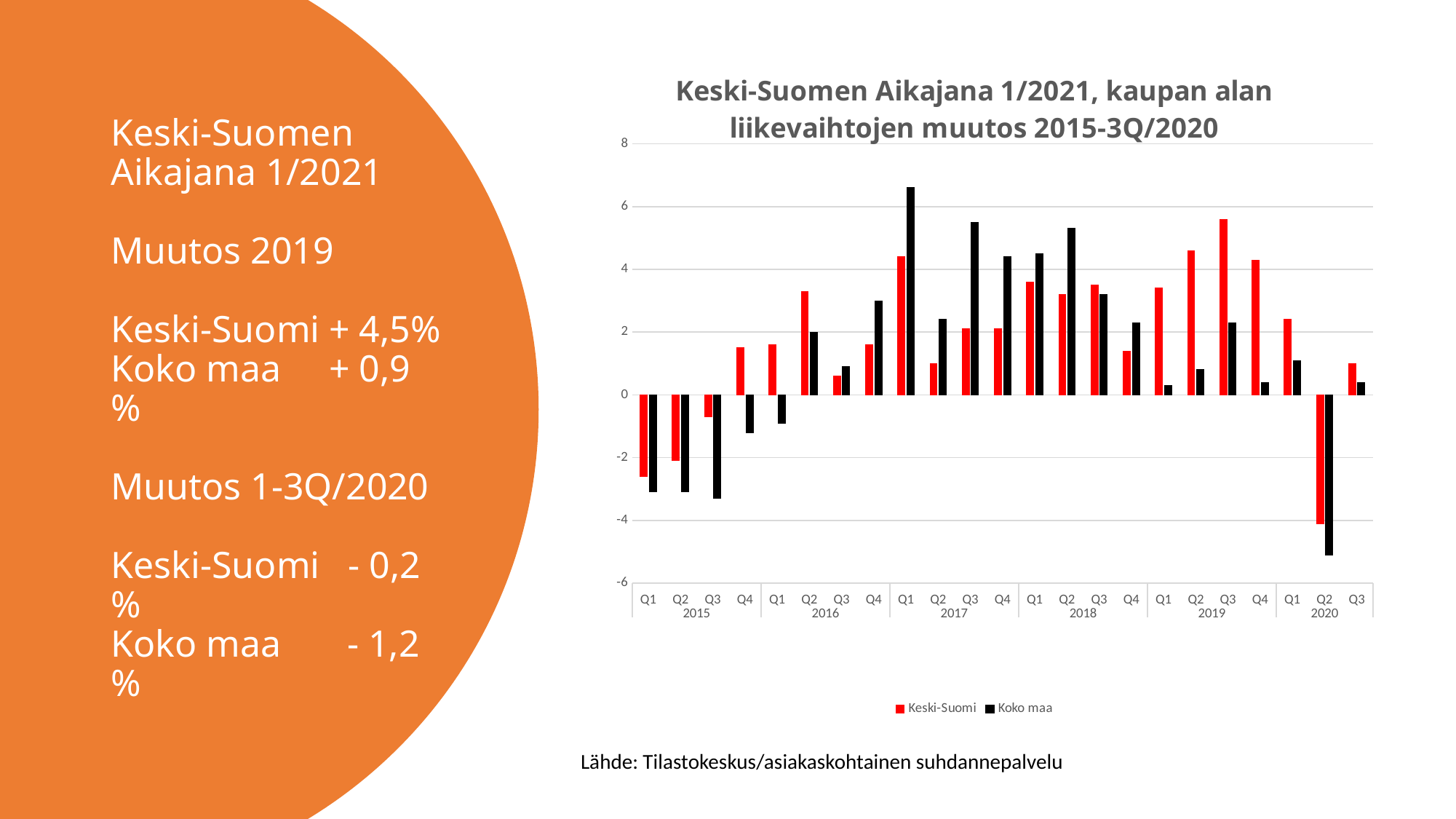
In Q3 2019, which series has the larger value, Keski-Suomi or Koko maa? Keski-Suomi How many series does the legend list? 2 Is the Koko maa value for Q1 2017 greater or less than 6? greater In which quarter does the Koko maa series reach its highest value? Q1 2017 Is the Koko maa value for Q2 2020 greater or less than -4? less In which quarter does the Keski-Suomi series reach its lowest value? Q2 2020 What kind of chart is shown on the slide? bar chart In which quarter does the Koko maa series reach its lowest value? Q2 2020 Is the Keski-Suomi value for Q3 2019 greater or less than 4? greater How many quarters are plotted on the x axis? 23 Which colour represents the Koko maa series in the chart? black In which quarter does the Keski-Suomi series reach its highest value? Q3 2019